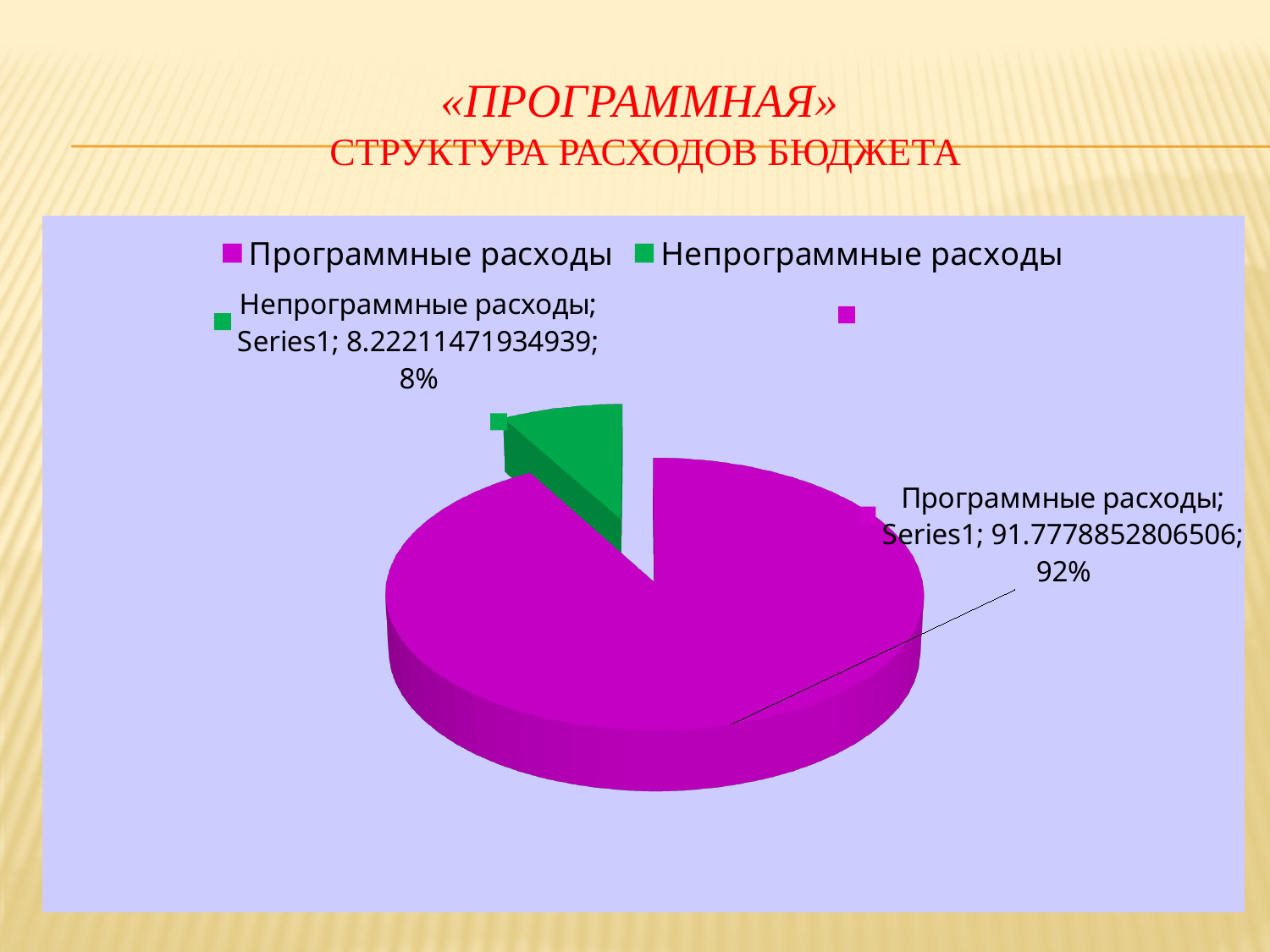
Which slice of the pie is the largest? Программные расходы What value is printed in the data label for Непрограммные расходы? 8.22211471934939 Which is larger: the share for Программные расходы or the share for Непрограммные расходы? Программные расходы How many entries does the legend list? 2 Which slice of the pie is the smallest? Непрограммные расходы What value is printed in the data label for Программные расходы? 91.7778852806506 What percentage share does the slice for Непрограммные расходы have? 8% What colour is the slice for Непрограммные расходы? green How many slices does the pie chart have? 2 What is the difference in percentage points between the shares of Программные расходы and Непрограммные расходы? 84 What percentage share does the slice for Программные расходы have? 92% What kind of chart is shown on the slide? pie chart